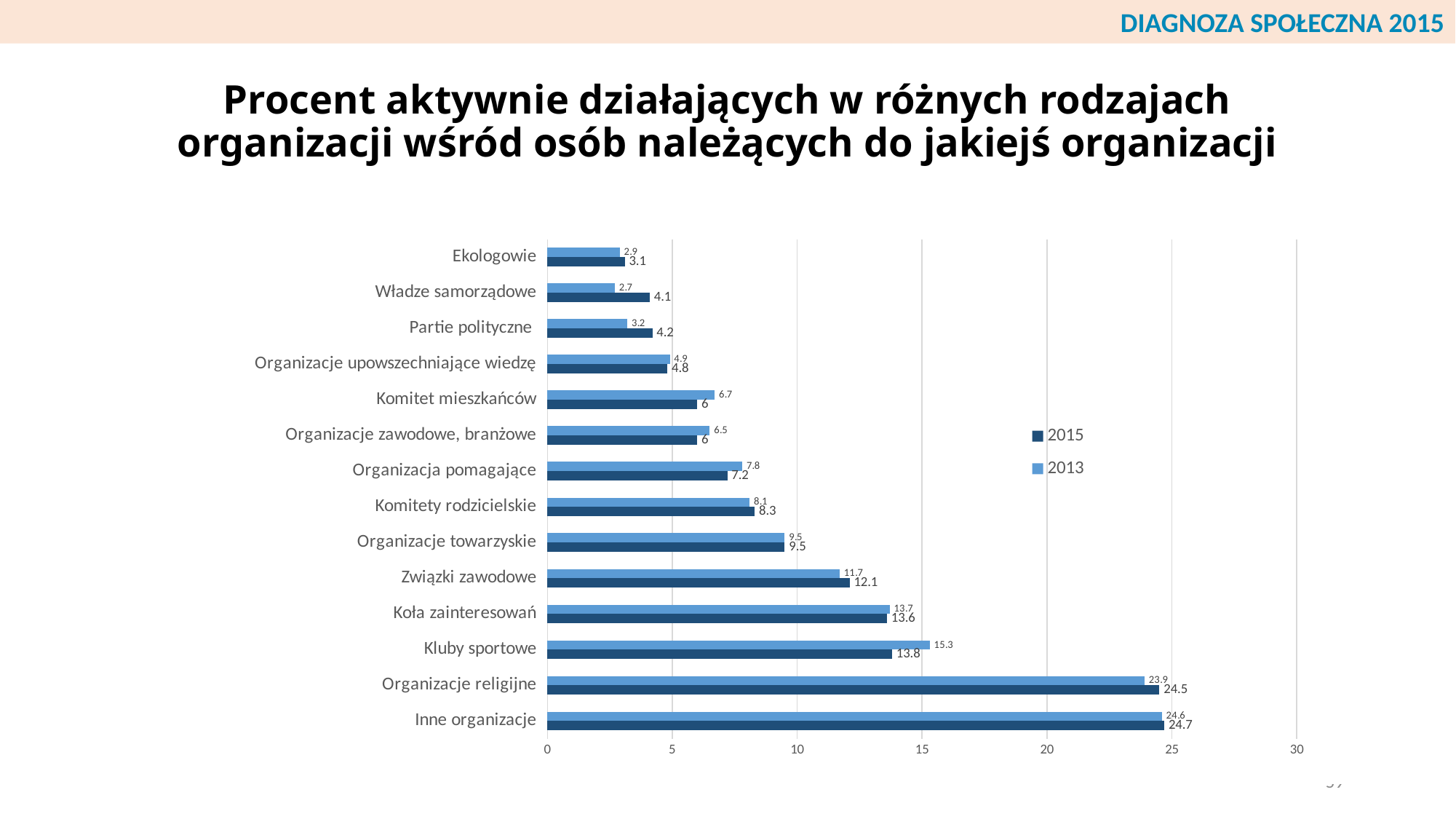
Which is larger for Związki zawodowe, the 2013 value or the 2015 value? 2015 Is the 2015 value for Organizacje religijne greater or less than 20? greater Which category has the highest 2015 value? Inne organizacje What type of chart is shown on the slide? bar chart What is the difference between the 2013 and 2015 values for Kluby sportowe? 1.5 What is the 2013 value for Organizacje religijne? 23.9 How many series does the legend list? 2 How many categories of organizations are shown in the chart? 14 Which category has the lowest 2013 value? Władze samorządowe Which series is shown in the darker blue colour? 2015 What is the 2015 value for Kluby sportowe? 13.8 What is the 2015 value for Władze samorządowe? 4.1